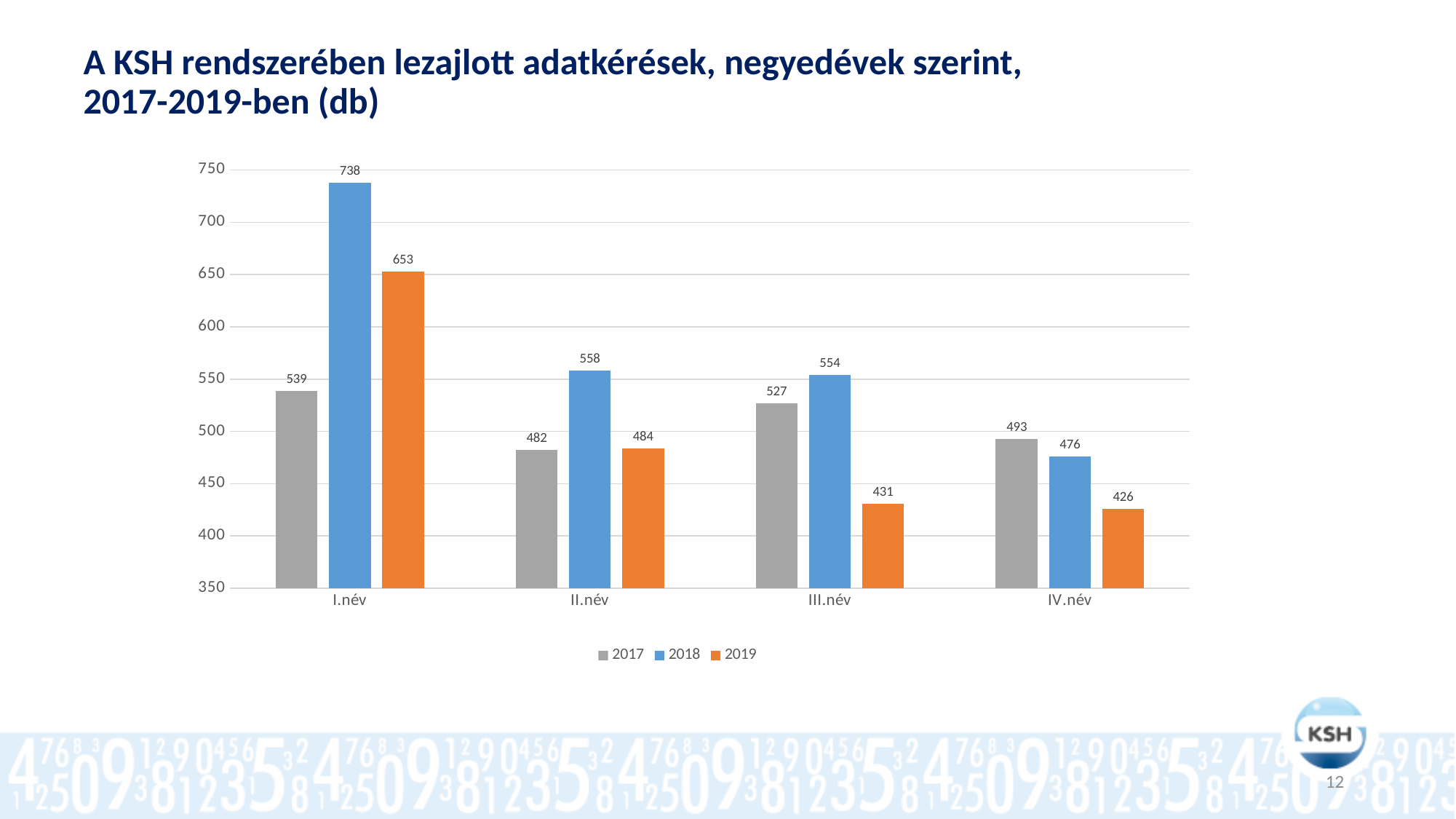
What is the value for 2017 in IV.név? 493 What is the difference between the 2018 and 2017 values in I.név? 199 Which colour represents the 2019 series in the legend? orange What is the value for 2019 in III.név? 431 Which quarter has the lowest value for the 2017 series? II.név Which quarter has the highest value for the 2019 series? I.név What is the value for 2018 in I.név? 738 What kind of chart is shown on the slide? bar chart Is the value for 2019 in II.név greater or less than 500? less Which is larger in IV.név: the 2017 value or the 2018 value? 2017 How many series does the legend list? 3 How many quarters are shown on the x axis? 4